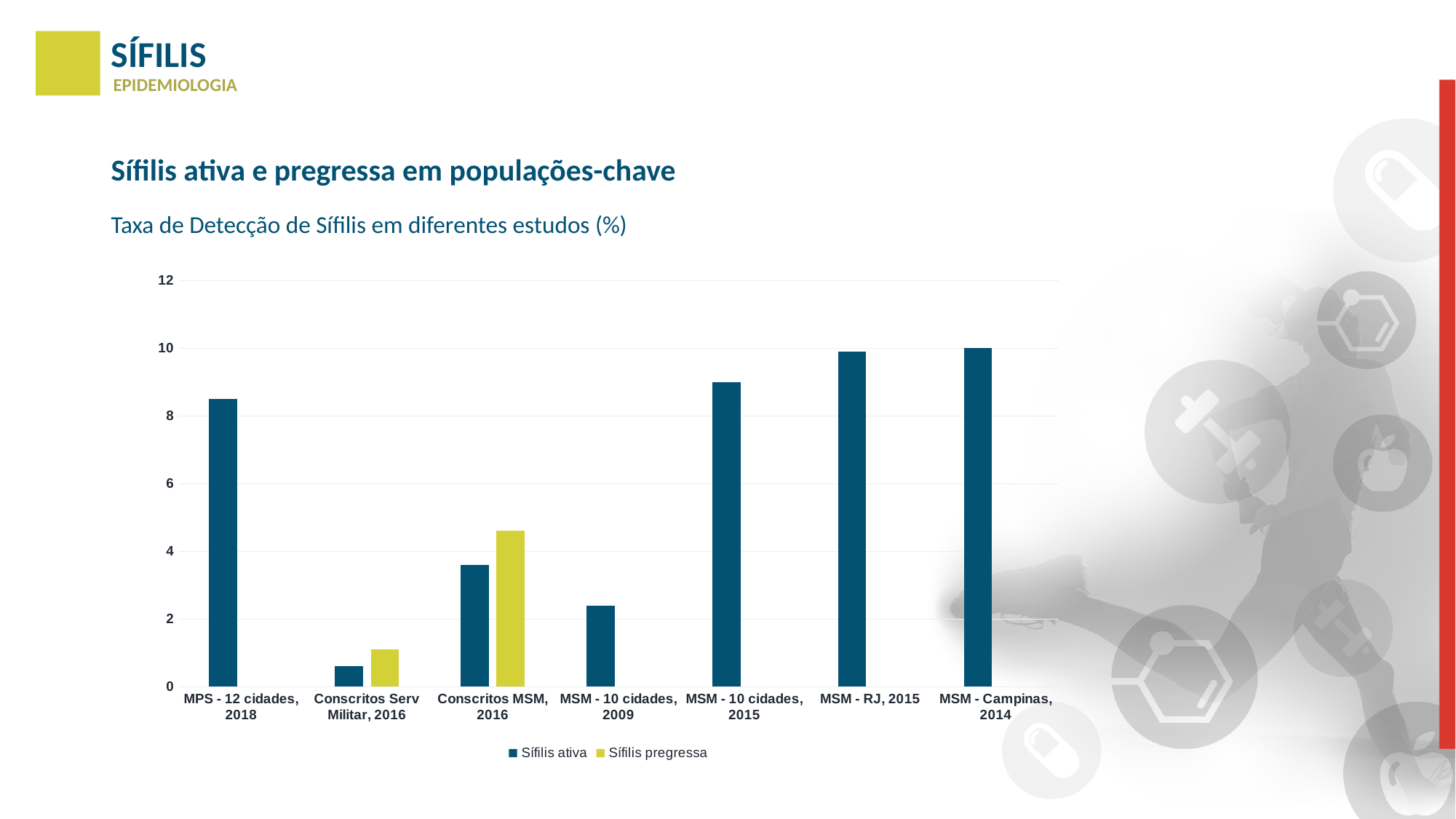
Is the Sífilis pregressa value for Conscritos MSM, 2016 greater or less than 4? greater How many study categories are shown on the x axis? 7 How many series does the legend list? 2 For Conscritos MSM, 2016, which is larger: Sífilis ativa or Sífilis pregressa? Sífilis pregressa What colour are the Sífilis pregressa bars? yellow-green Is the Sífilis ativa value for Conscritos Serv Militar, 2016 greater or less than 2? less What kind of chart is shown on the slide? bar chart Which category has the lowest value for Sífilis ativa? Conscritos Serv Militar, 2016 Is the Sífilis ativa value for MPS - 12 cidades, 2018 greater or less than 8? greater Which has a larger Sífilis ativa value: MPS - 12 cidades, 2018 or MSM - 10 cidades, 2009? MPS - 12 cidades, 2018